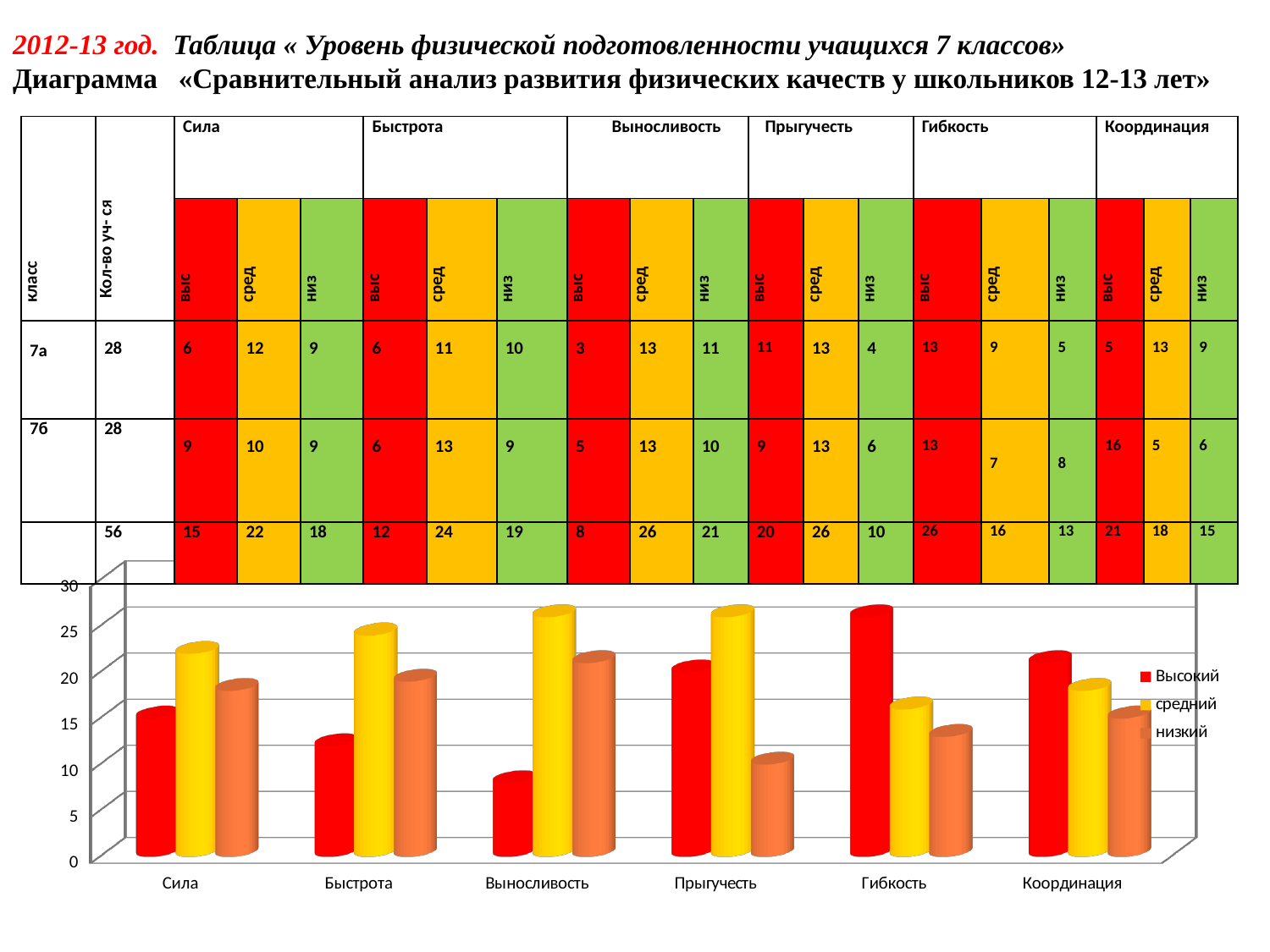
How many series does the legend of the bar chart list? 3 In the bar chart, is the Высокий value for Выносливость greater or less than 10? less In the bar chart, which category has the lowest value for the Высокий series? Выносливость In the bar chart, which category has the lowest value for the низкий series? Прыгучесть Which series in the bar chart is drawn in red? Высокий How many categories are shown on the x axis of the bar chart? 6 In the bar chart, for Гибкость, which is larger: Высокий or низкий? Высокий In the bar chart, is the средний value for Быстрота greater or less than 20? greater What are the three legend entries of the bar chart? Высокий, средний, низкий In the bar chart, for Сила, which is larger: Высокий or средний? средний In the bar chart, which category has the highest value for the Высокий series? Гибкость What kind of chart is shown at the bottom of the slide? bar chart